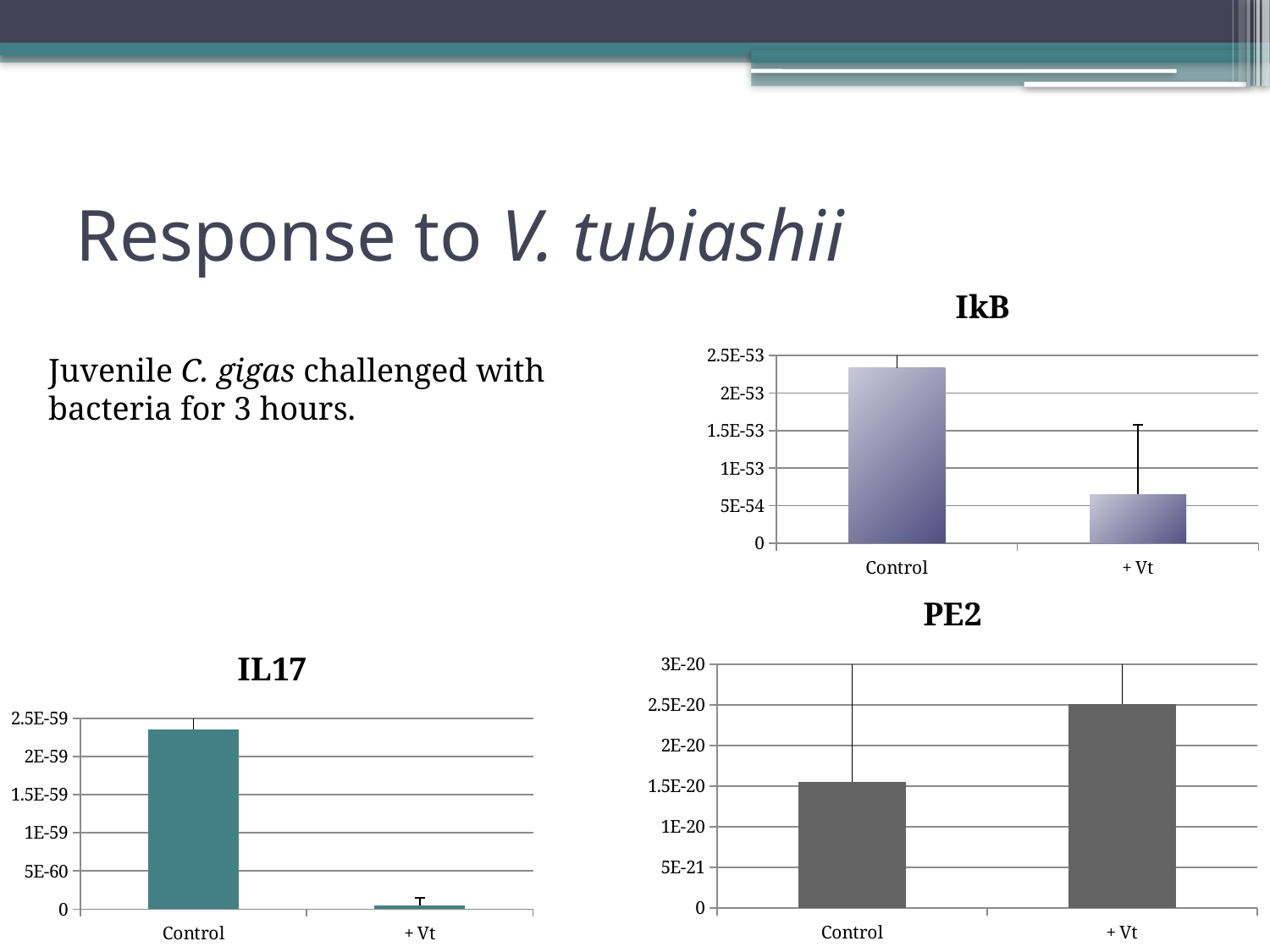
In the PE2 chart, which category has the highest value? + Vt Do the values in the PE2 chart rise or fall from Control to + Vt? rise How many categories are shown on the x axis of the IL17 chart? 2 In the IL17 chart, which category has the lowest value? + Vt In the IkB chart, which category has the highest value? Control In the IkB chart, which is larger, the value for Control or the value for + Vt? Control What kind of chart is the IkB chart? bar chart In the IL17 chart, is the value for Control greater or less than 2E-59? greater In the PE2 chart, is the value for Control greater or less than 2E-20? less In the IkB chart, is the value for + Vt greater or less than 1E-53? less